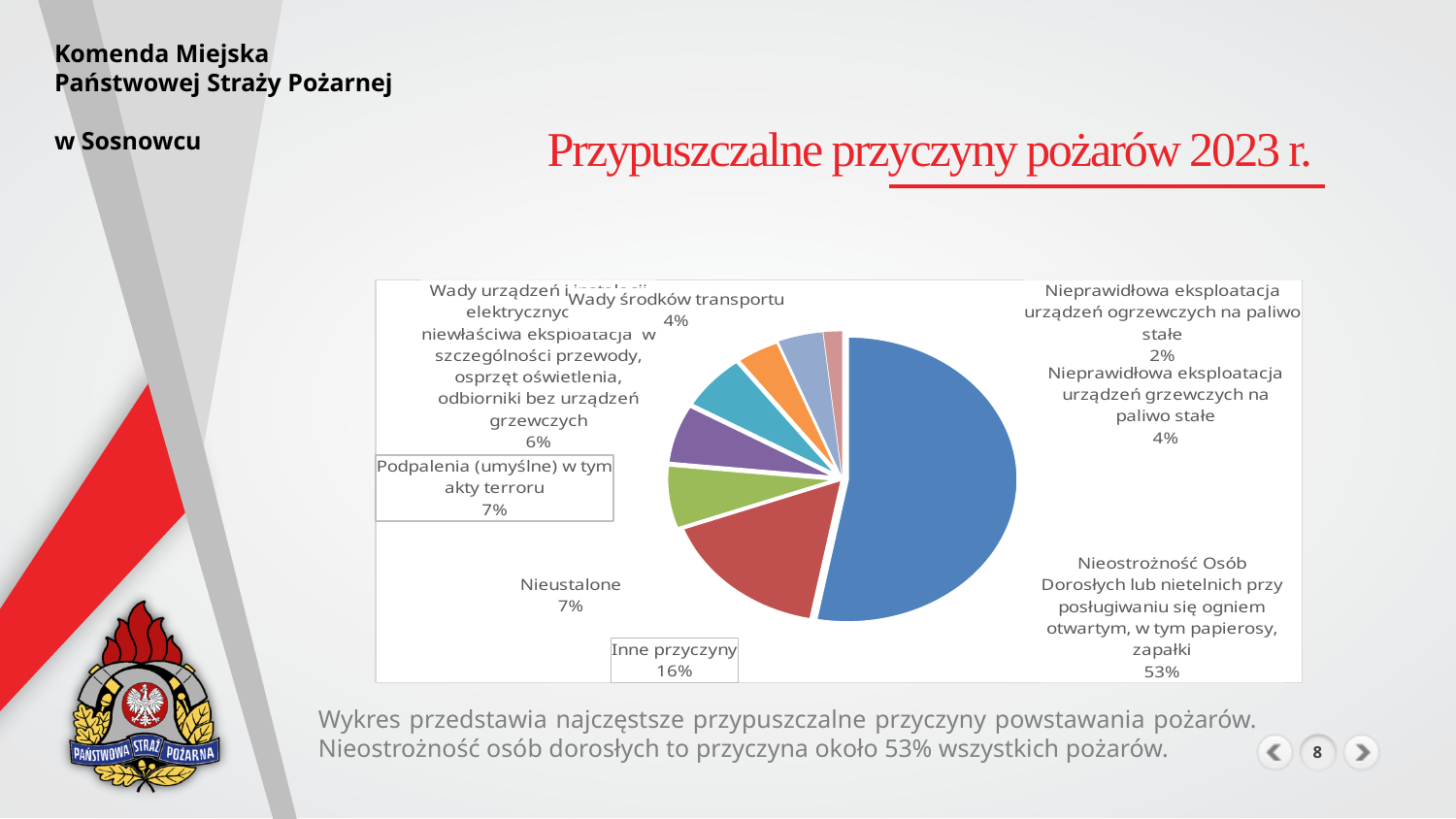
Which category has the smallest share of the pie? Nieprawidłowa eksploatacja urządzeń ogrzewczych na paliwo stałe How many slices does the pie chart have? 8 Which is larger: the share for "Inne przyczyny" or the share for "Nieustalone"? Inne przyczyny What percentage is shown for "Wady środków transportu"? 4% Which category has the largest share of the pie? Nieostrożność Osób Dorosłych lub nietelnich przy posługiwaniu się ogniem otwartym, w tym papierosy, zapałki What is the title of the chart? Przypuszczalne przyczyny pożarów 2023 r. What percentage is shown for "Nieustalone"? 7% What is the difference in percentage points between "Nieostrożność Osób Dorosłych..." (53%) and "Inne przyczyny" (16%)? 37 What kind of chart is shown on the slide? pie chart What percentage is shown for the slice about faults in electrical devices and installations ("Wady urządzeń i instalacji elektrycznych...")? 6% What share of the pie is labelled "Inne przyczyny"? 16% What percentage is shown for "Podpalenia (umyślne) w tym akty terroru"? 7%